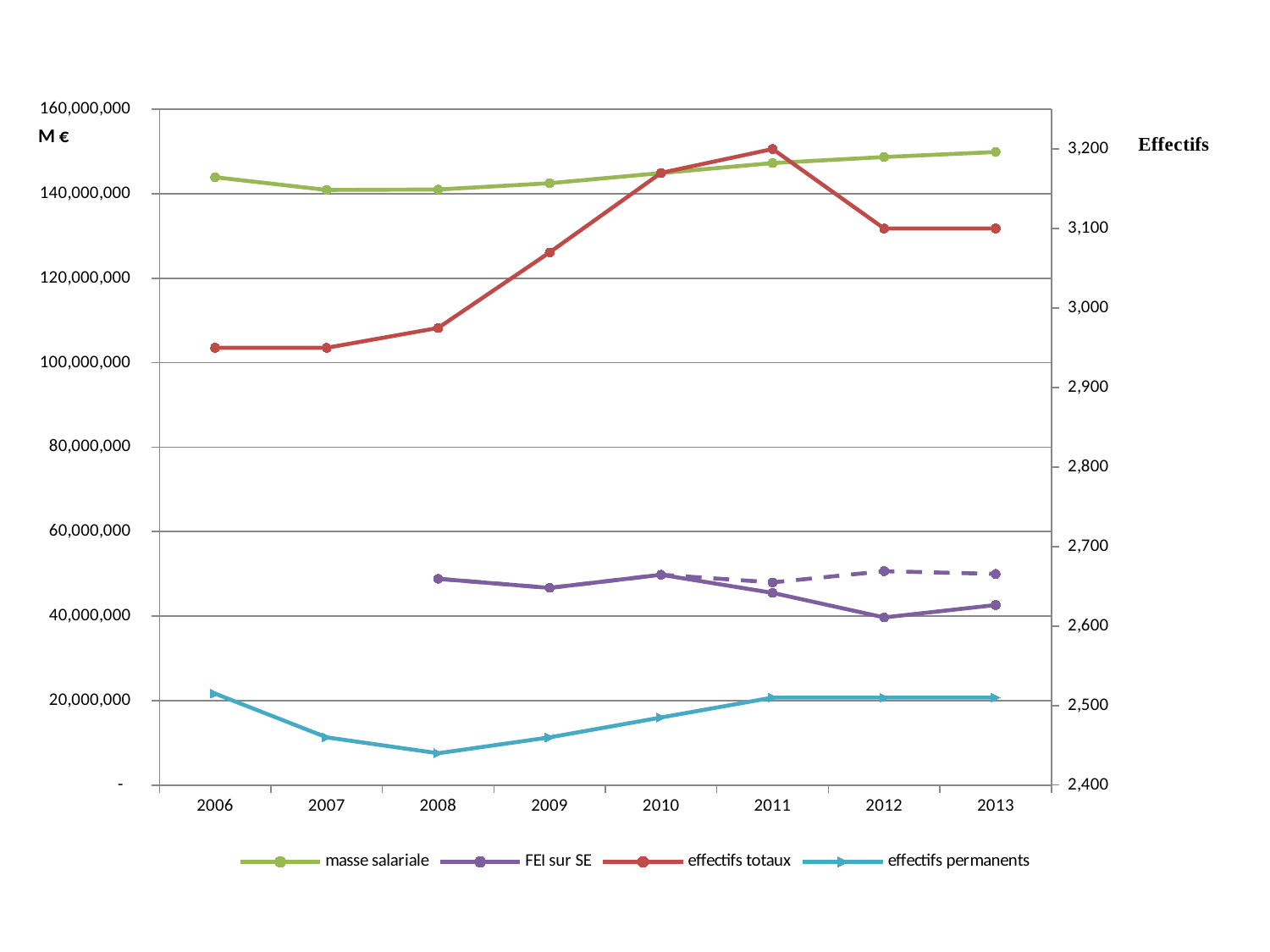
In which year is effectifs permanents lowest? 2008 Is the value for effectifs totaux in 2006 greater or less than 3,000? less Which is larger, effectifs totaux in 2010 or in 2012? 2010 In which year is masse salariale highest? 2013 How many series does the legend list? 4 Is the value for masse salariale in 2013 greater or less than 140,000,000? greater Does effectifs totaux rise or fall from 2007 to 2011? rise What is the label of the right-hand vertical axis? Effectifs Is the value for effectifs totaux in 2011 greater or less than 3,100? greater How many years are shown on the x axis? 8 What kind of chart is shown on the slide? line chart In which year is effectifs totaux highest? 2011